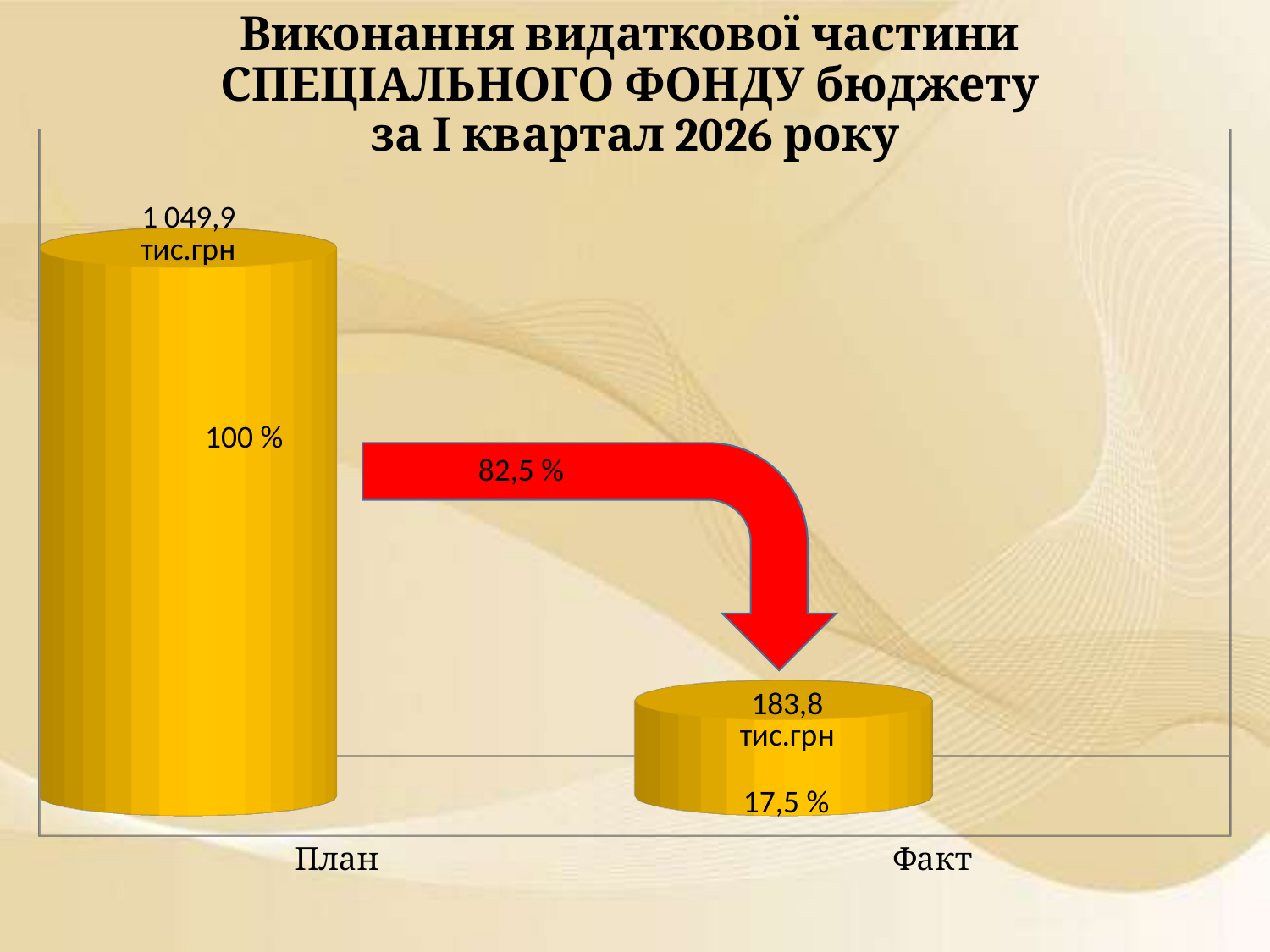
What kind of chart is shown on the slide? Bar chart What is the value for План? 1 049,9 тис.грн What percentage is written on the red arrow between the two bars? 82,5 % What is the difference between the values for План and Факт? 866,1 тис.грн What percentage is shown for Факт? 17,5 % What percentage is shown for План? 100 % How many categories are shown on the chart? 2 What is the title of the chart? Виконання видаткової частини СПЕЦІАЛЬНОГО ФОНДУ бюджету за І квартал 2026 року What is the value for Факт? 183,8 тис.грн Which is larger, the value for План or the value for Факт? План Which category has the lowest value? Факт Which category has the highest value? План